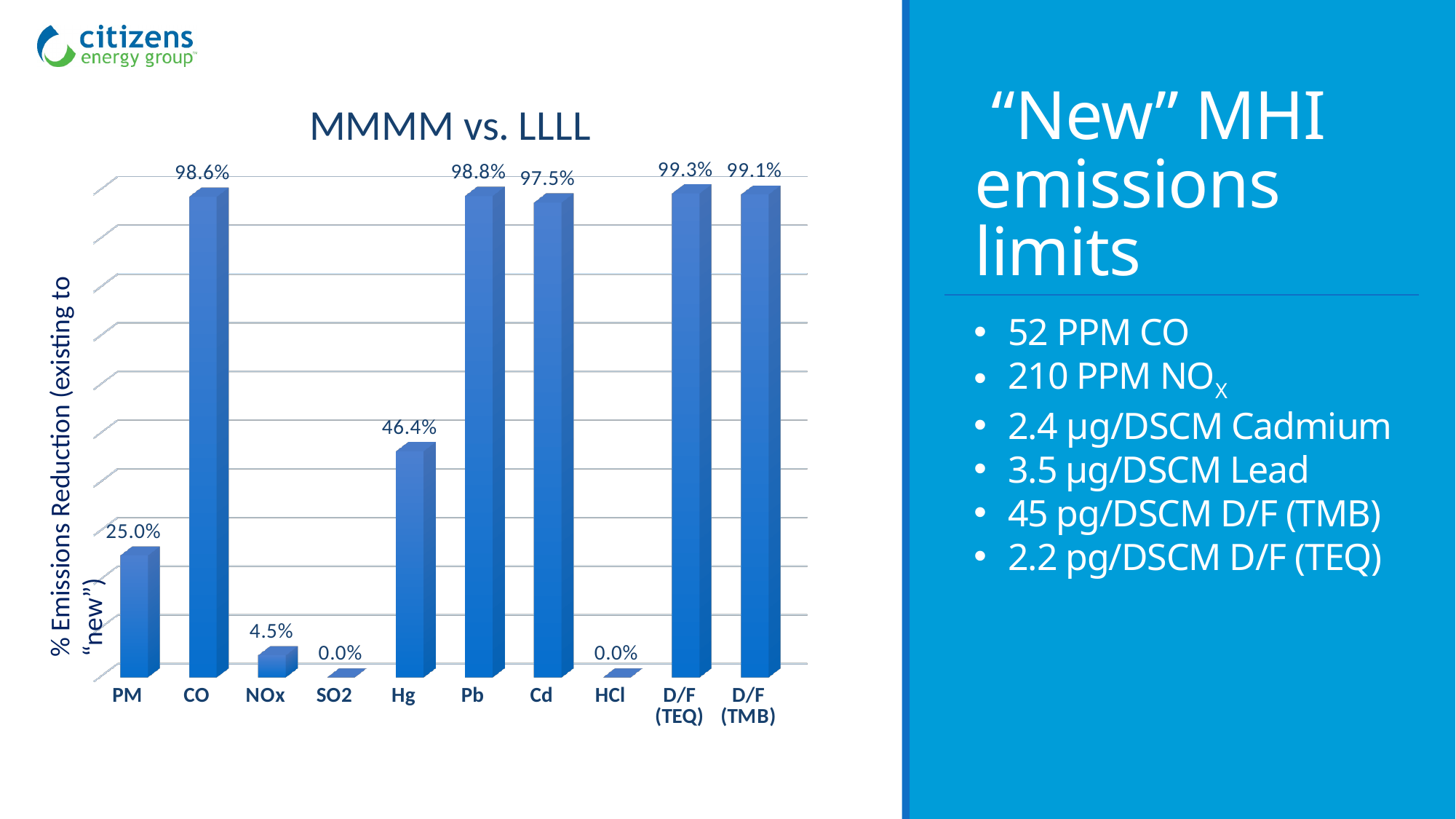
Which category has the highest value in the chart? D/F (TEQ) What is the title of the chart? MMMM vs. LLLL Which is larger, the value for Pb or the value for Cd? Pb What is the value for CO in the chart? 98.6% What is the value for Hg in the chart? 46.4% What is the value for NOx in the chart? 4.5% Which is larger, the value for Hg or the value for PM? Hg What is the difference between the values for CO and PM? 73.6% How many categories are shown on the x axis of the chart? 10 What is the value for D/F (TMB) in the chart? 99.1% What kind of chart is shown on the slide? Bar chart What is the difference between the values for Hg and NOx? 41.9%